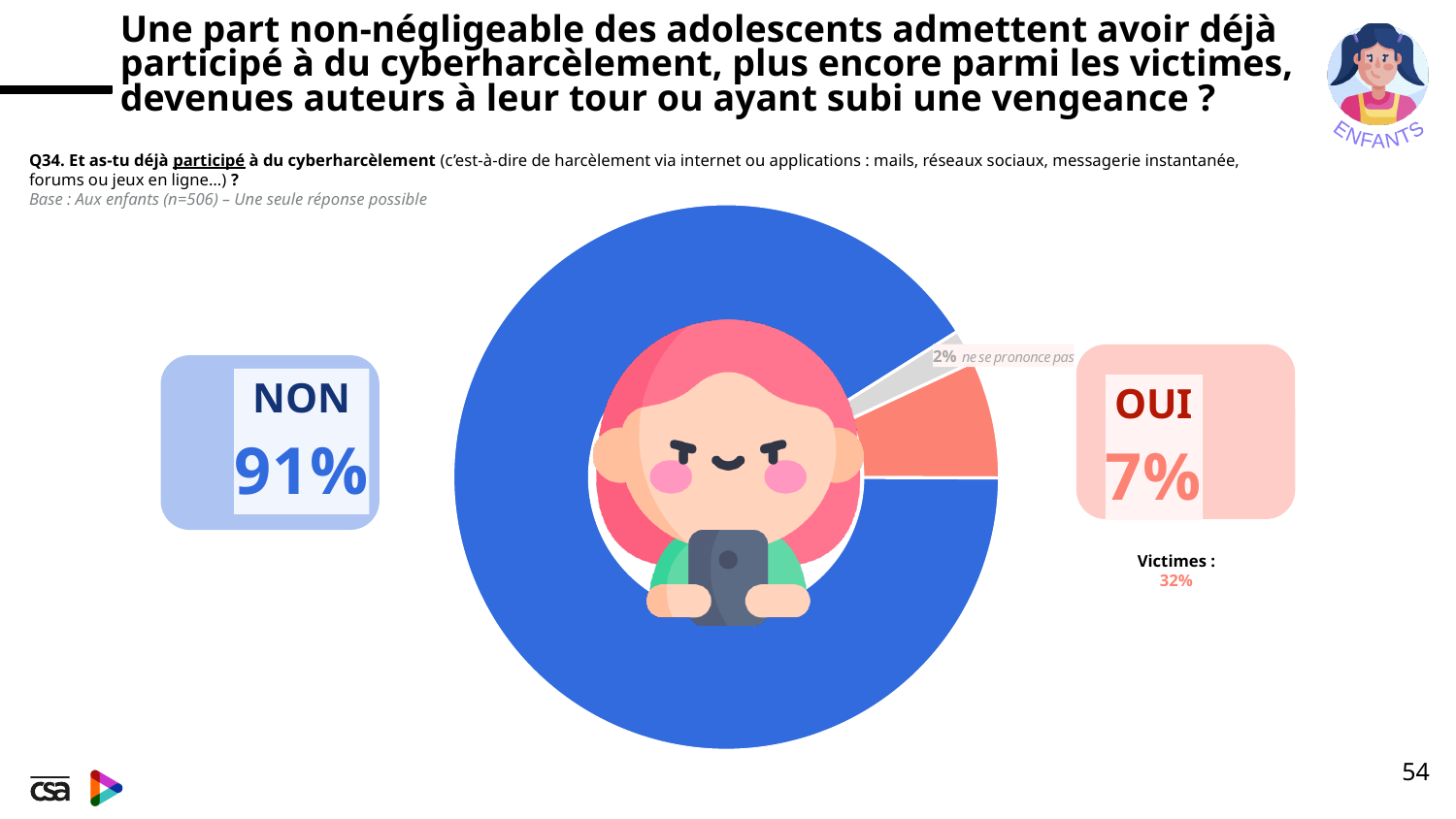
Which answer has the largest share of the pie? NON What share of respondents answered 'ne se prononce pas'? 2% What is the difference in percentage points between NON and OUI? 84 What kind of chart is shown on the slide? pie chart What colour is the NON slice of the pie chart? blue Which is larger, the share for OUI or the share for 'ne se prononce pas'? OUI Which answer has the smallest share of the pie? ne se prononce pas What is the sample size (n) given in the base line under the question? 506 How many slices does the pie chart have? 3 What percentage is shown for 'Victimes' next to the OUI box? 32% What share of respondents answered NON? 91% What share of respondents answered OUI? 7%